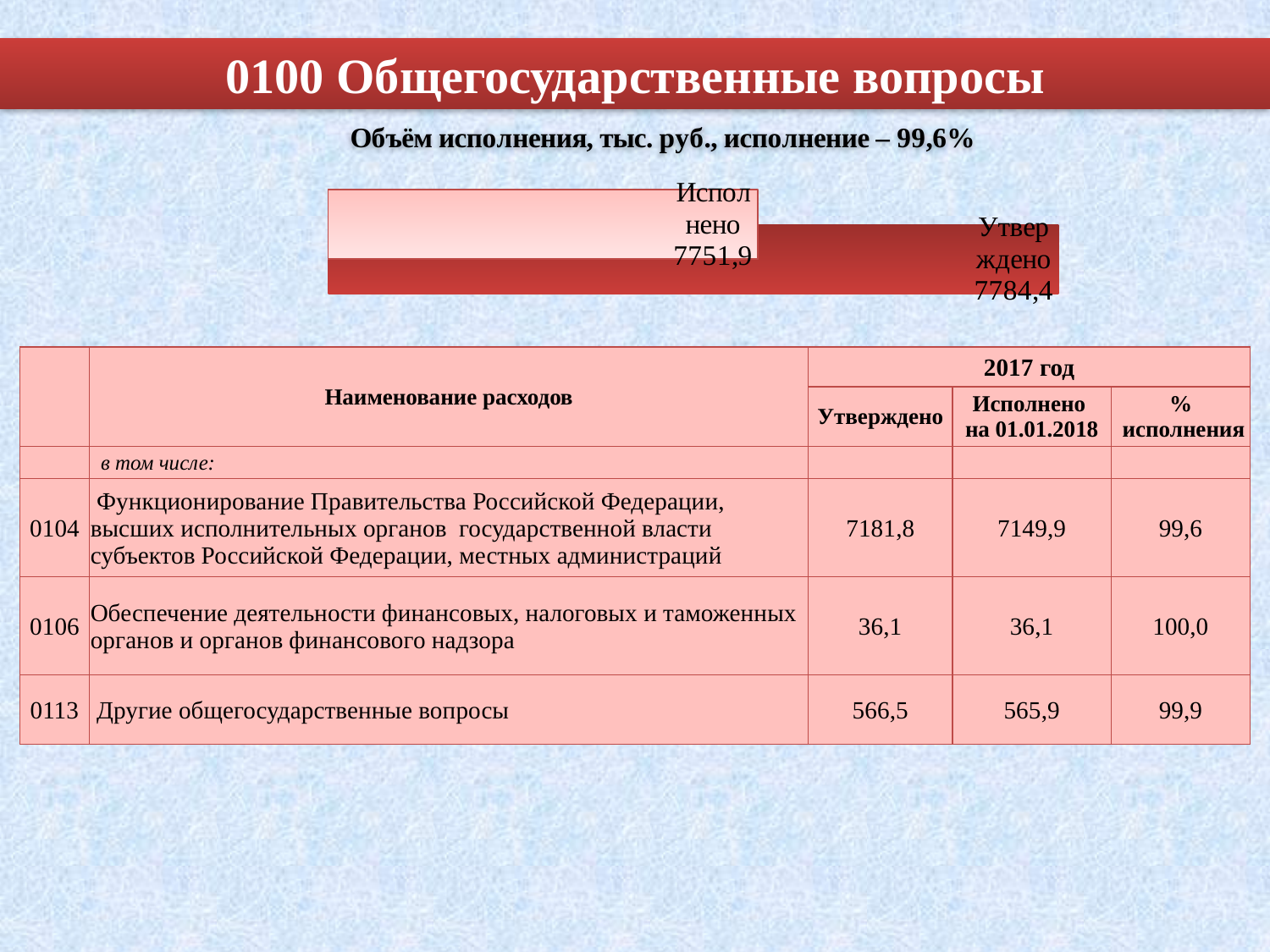
What type of chart is shown on the slide? bar chart What is the value of the Утверждено bar in the chart? 7784,4 What is the difference between the Утверждено value and the Исполнено value in the chart? 32,5 What is the title shown above the chart? Объём исполнения, тыс. руб., исполнение – 99,6% How many bars are plotted in the chart? 2 What unit of measurement does the chart title state the values are in? тыс. руб. Is the value for Утверждено larger or smaller than the value for Исполнено? larger What is the value of the Исполнено bar in the chart? 7751,9 Which bar in the chart has the lower value? Исполнено Which bar in the chart has the higher value? Утверждено